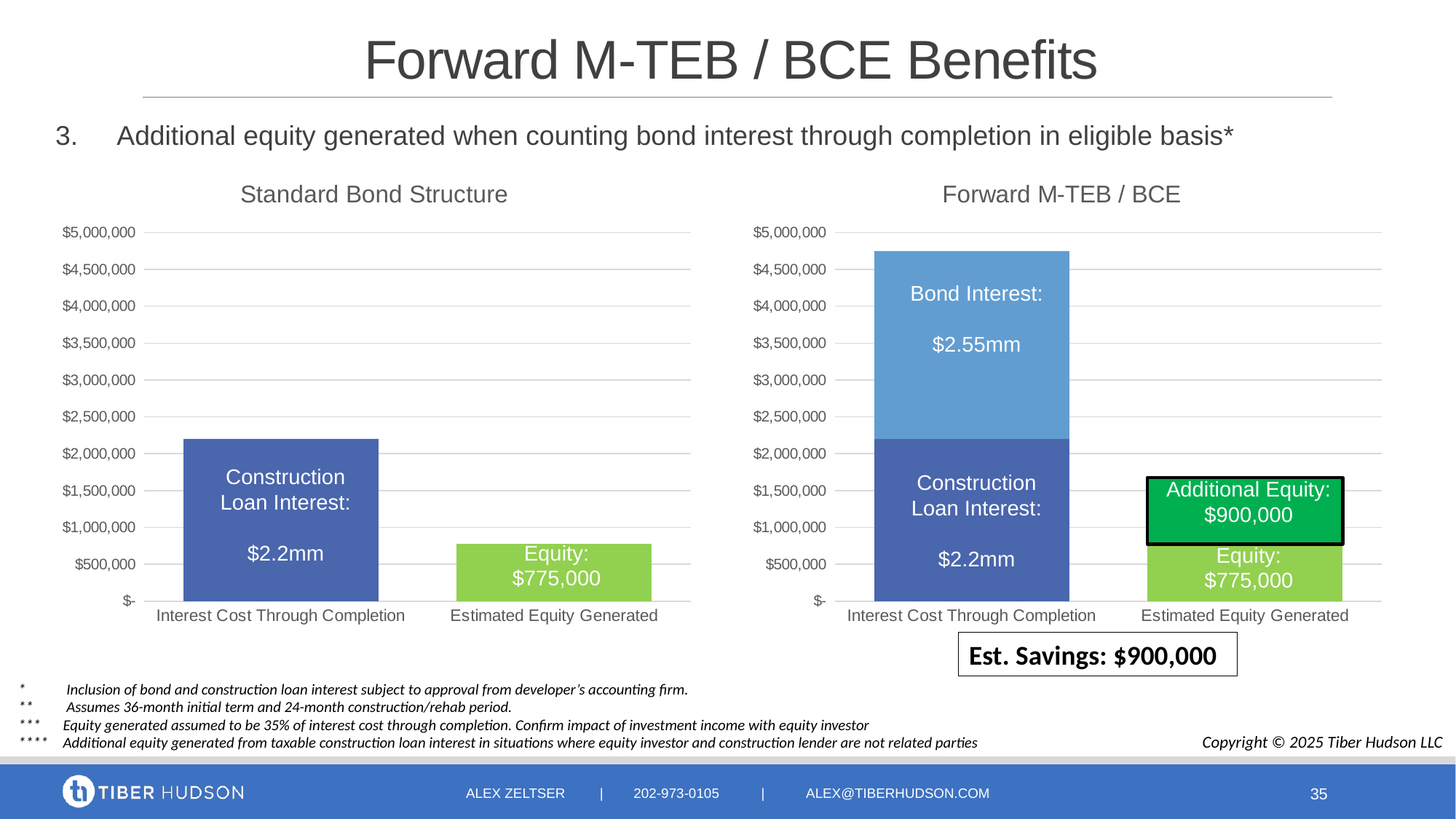
In the Forward M-TEB / BCE chart, what is the total of the Interest Cost Through Completion stacked bar? $4.75mm In the Forward M-TEB / BCE chart, is the total for Interest Cost Through Completion greater or less than $4,500,000? greater What kind of chart is the Forward M-TEB / BCE chart? Stacked bar chart In the Standard Bond Structure chart, which category has the higher value, Interest Cost Through Completion or Estimated Equity Generated? Interest Cost Through Completion What is the title of the chart on the left side of the slide? Standard Bond Structure In the Standard Bond Structure chart, what is the value of Construction Loan Interest? $2.2mm In the Forward M-TEB / BCE chart, what is the total of the Estimated Equity Generated stacked bar? $1,675,000 In the Forward M-TEB / BCE chart, what is the value of Additional Equity? $900,000 In the Forward M-TEB / BCE chart, what is the difference between Additional Equity and Equity? $125,000 In the Forward M-TEB / BCE chart, what is the value of Bond Interest? $2.55mm In the Standard Bond Structure chart, what is the value of Equity for Estimated Equity Generated? $775,000 How many categories are shown on the x axis of the Standard Bond Structure chart? 2